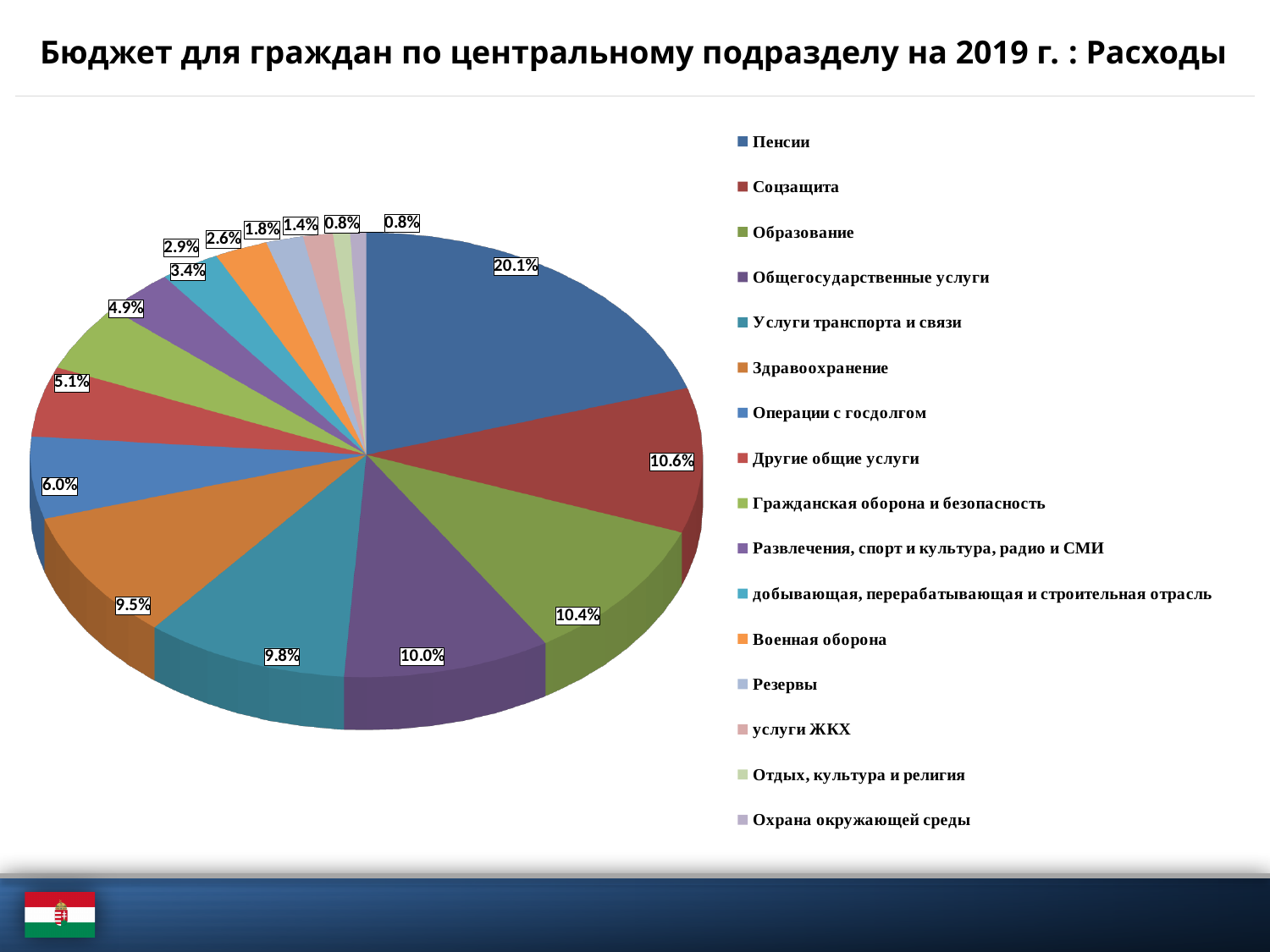
Which category has the largest share of expenditures? Пенсии What share of expenditures goes to Военная оборона? 2.6% What share of expenditures goes to Пенсии? 20.1% What share of expenditures goes to Соцзащита? 10.6% What share of expenditures goes to Здравоохранение? 9.5% What is the difference between the shares for Пенсии and Соцзащита? 9.5% What is the title of the chart on the slide? Бюджет для граждан по центральному подразделу на 2019 г. : Расходы What kind of chart is shown on the slide? Pie chart How many categories does the legend list? 16 What is the difference between the shares for Услуги транспорта и связи and Здравоохранение? 0.3% What share of expenditures goes to Операции с госдолгом? 6.0% Which has a larger share, Образование or Общегосударственные услуги? Образование